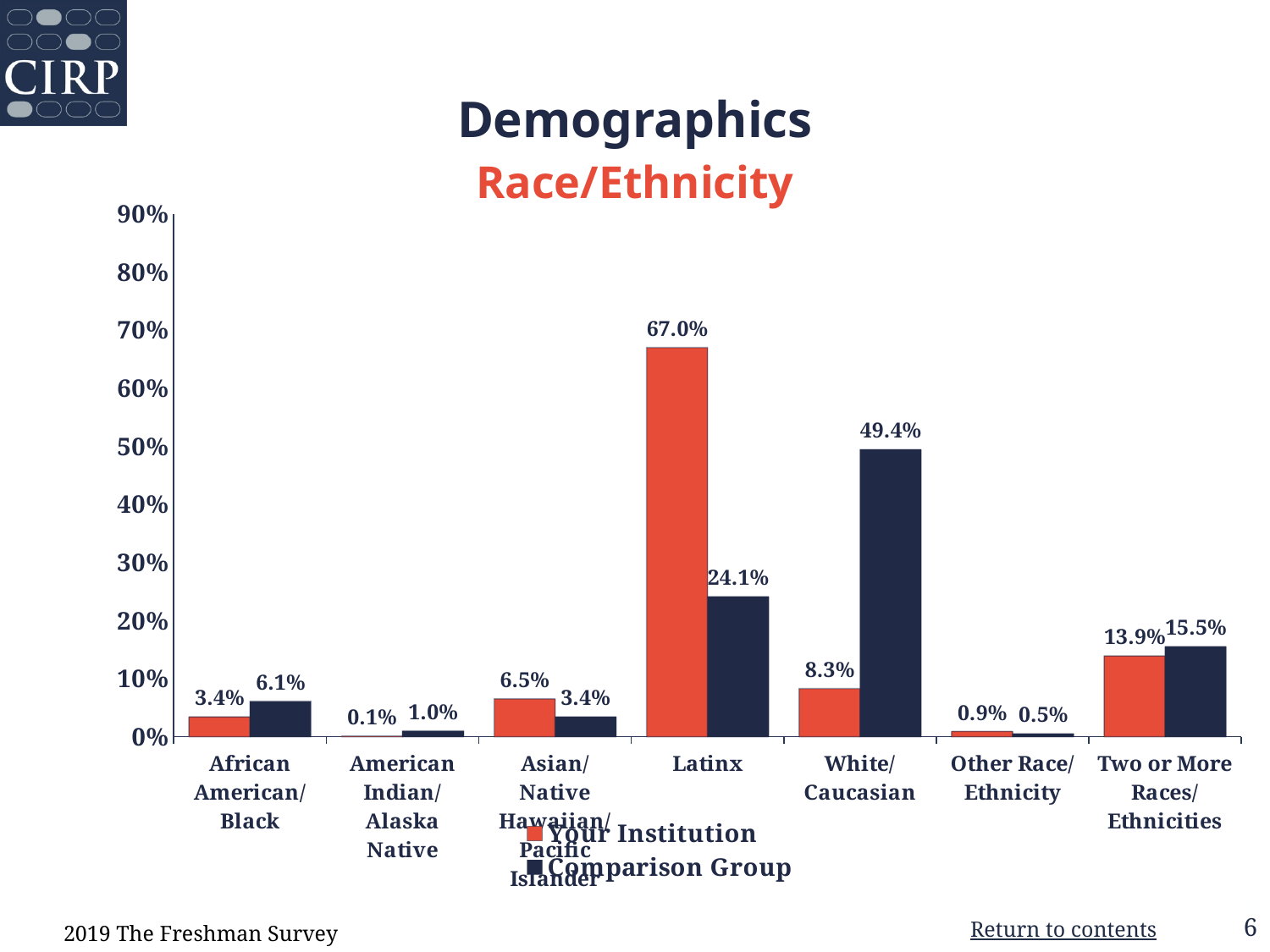
What is the value for Your Institution in the African American/Black category? 3.4% What is the value for the Comparison Group in the Two or More Races/Ethnicities category? 15.5% What is the value for the Comparison Group in the White/Caucasian category? 49.4% Which category has the highest value for Your Institution? Latinx Which category has the lowest value for Your Institution? American Indian/Alaska Native What is the value for Your Institution in the Latinx category? 67.0% How many race/ethnicity categories are shown on the x axis? 7 What kind of chart is shown on the slide? Bar chart In the White/Caucasian category, which is larger: Your Institution or the Comparison Group? Comparison Group How many series does the legend list? 2 Which category has the highest value for the Comparison Group? White/Caucasian What is the difference between Your Institution and the Comparison Group in the Latinx category? 42.9%